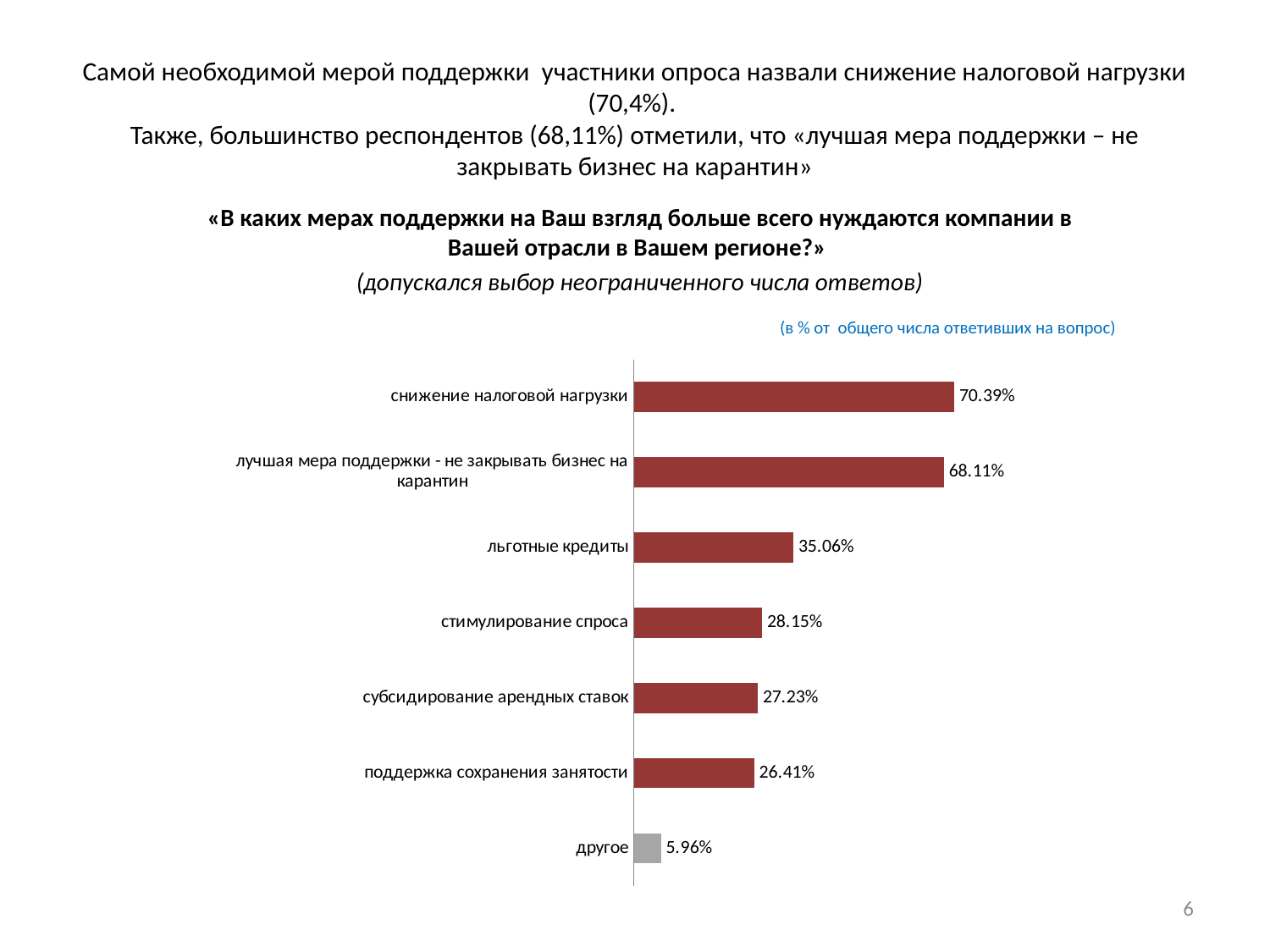
What is the value for «другое»? 5.96% What is the difference between «льготные кредиты» and «стимулирование спроса»? 6.91% What is the value for «субсидирование арендных ставок»? 27.23% Which category has the lowest value? другое Which category has the highest value? снижение налоговой нагрузки What is the value for «снижение налоговой нагрузки»? 70.39% How many categories are shown in the chart? 7 What is the difference between «снижение налоговой нагрузки» and «лучшая мера поддержки - не закрывать бизнес на карантин»? 2.28% What kind of chart is shown on the slide? bar chart What is the value for «льготные кредиты»? 35.06% Which is larger: «стимулирование спроса» or «поддержка сохранения занятости»? стимулирование спроса Which bar is shown in a different colour (grey) from the others? другое